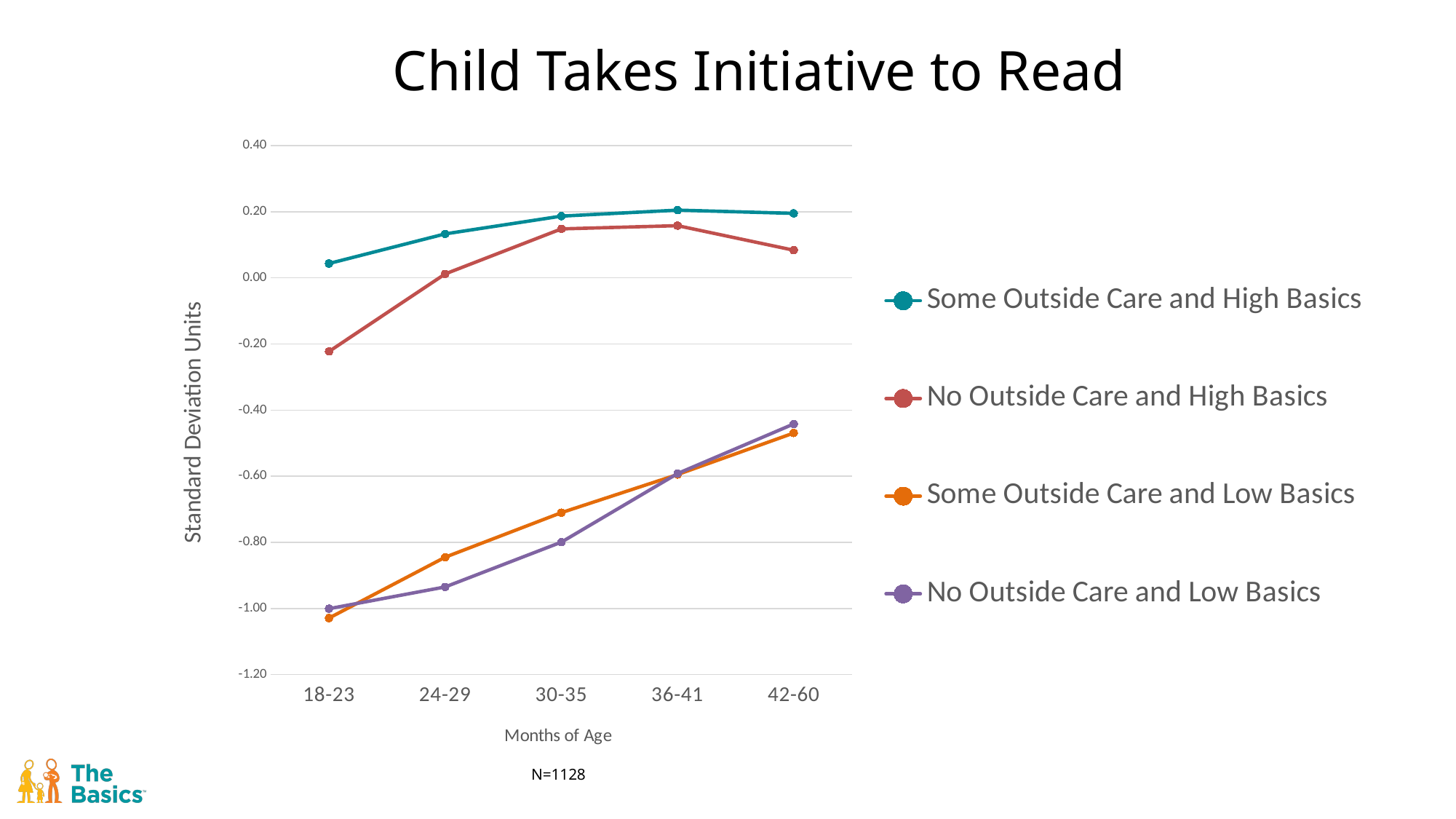
What kind of chart is shown on the slide? line chart Is the value for No Outside Care and High Basics at 18-23 months greater or less than 0.00? less What is the title of the chart? Child Takes Initiative to Read Which series has the lowest value at 30-35 months? No Outside Care and Low Basics Is the value for No Outside Care and High Basics at 42-60 months greater or less than 0.00? greater Does the No Outside Care and Low Basics line rise or fall across the age groups from 18-23 to 42-60? rise What is the label of the y axis? Standard Deviation Units How many age groups are shown on the x axis? 5 Is the value for Some Outside Care and Low Basics at 30-35 months greater or less than -0.80? greater How many series does the legend list? 4 Which series has the highest value at 42-60 months? Some Outside Care and High Basics At 18-23 months, which is higher: Some Outside Care and High Basics or No Outside Care and High Basics? Some Outside Care and High Basics